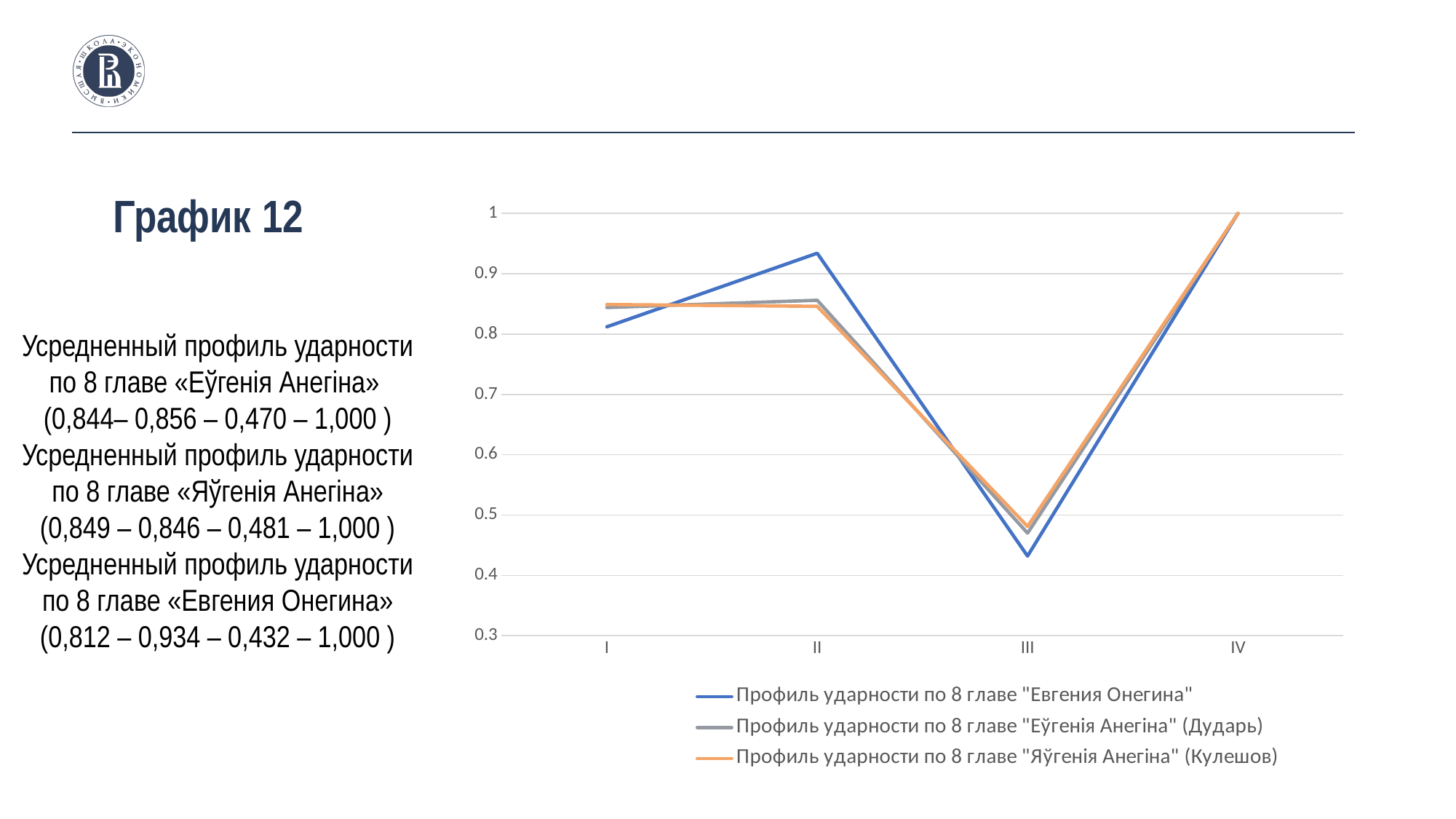
Is the value for "Евгения Онегина" at position III greater or less than 0.5? less Do the values of all three series rise or fall from position II to position III? fall What colour is the line for "Профиль ударности по 8 главе "Евгения Онегина""? blue At position II, which series has the higher value: "Евгения Онегина" or "Еўгенія Анегіна" (Дударь)? Евгения Онегина What kind of chart is shown on the slide? line chart How many series does the chart legend list? 3 According to the text on the slide, what is the averaged stress profile value at position III for «Евгения Онегина»? 0,432 How many points are plotted along the x axis for each series? 4 At position I, which series has the lower value: "Евгения Онегина" or "Яўгенія Анегіна" (Кулешов)? Евгения Онегина At which x-axis position do all three series reach their highest value? IV At which x-axis position does the series "Профиль ударности по 8 главе "Евгения Онегина"" reach its lowest value? III Is the value for "Евгения Онегина" at position II greater or less than 0.9? greater